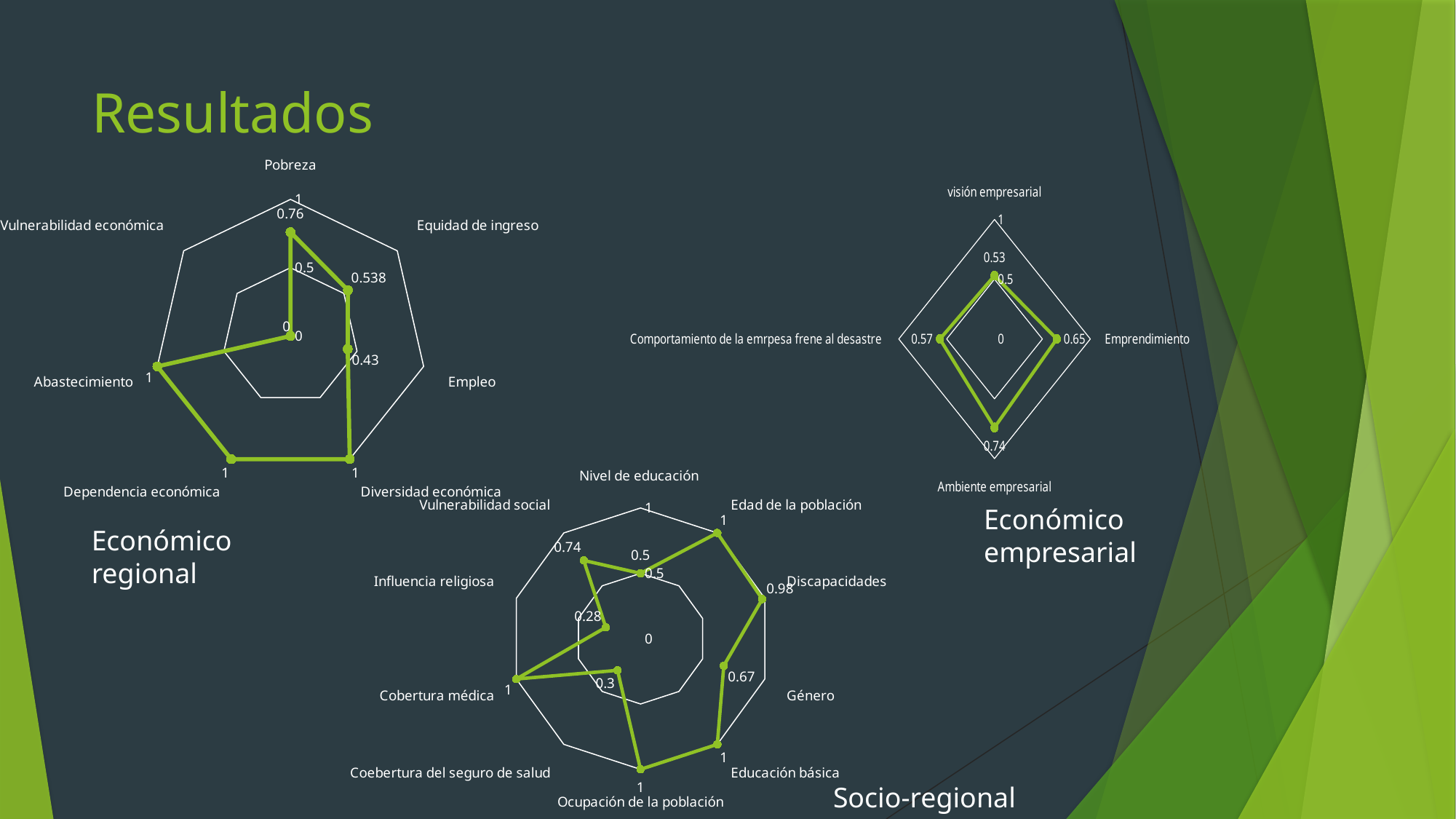
In the Económico regional chart, what is the value for Empleo? 0.43 In the Económico regional chart, which category has the lowest value? Vulnerabilidad económica In the Económico empresarial chart, what is the difference between Ambiente empresarial and visión empresarial? 0.21 In the Económico empresarial chart, which category has the highest value? Ambiente empresarial In the Económico empresarial chart, what is the value for Emprendimiento? 0.65 In the Socio-regional chart, what is the value for Discapacidades? 0.98 In the Socio-regional chart, which is larger, Género or Cobertura del seguro de salud? Género What type of chart is the Socio-regional chart? Radar chart In the Económico regional chart, what is the value for Pobreza? 0.76 In the Económico regional chart, what is the value for Equidad de ingreso? 0.538 In the Socio-regional chart, which category has the lowest value? Influencia religiosa In the Económico regional chart, how many categories are plotted? 7